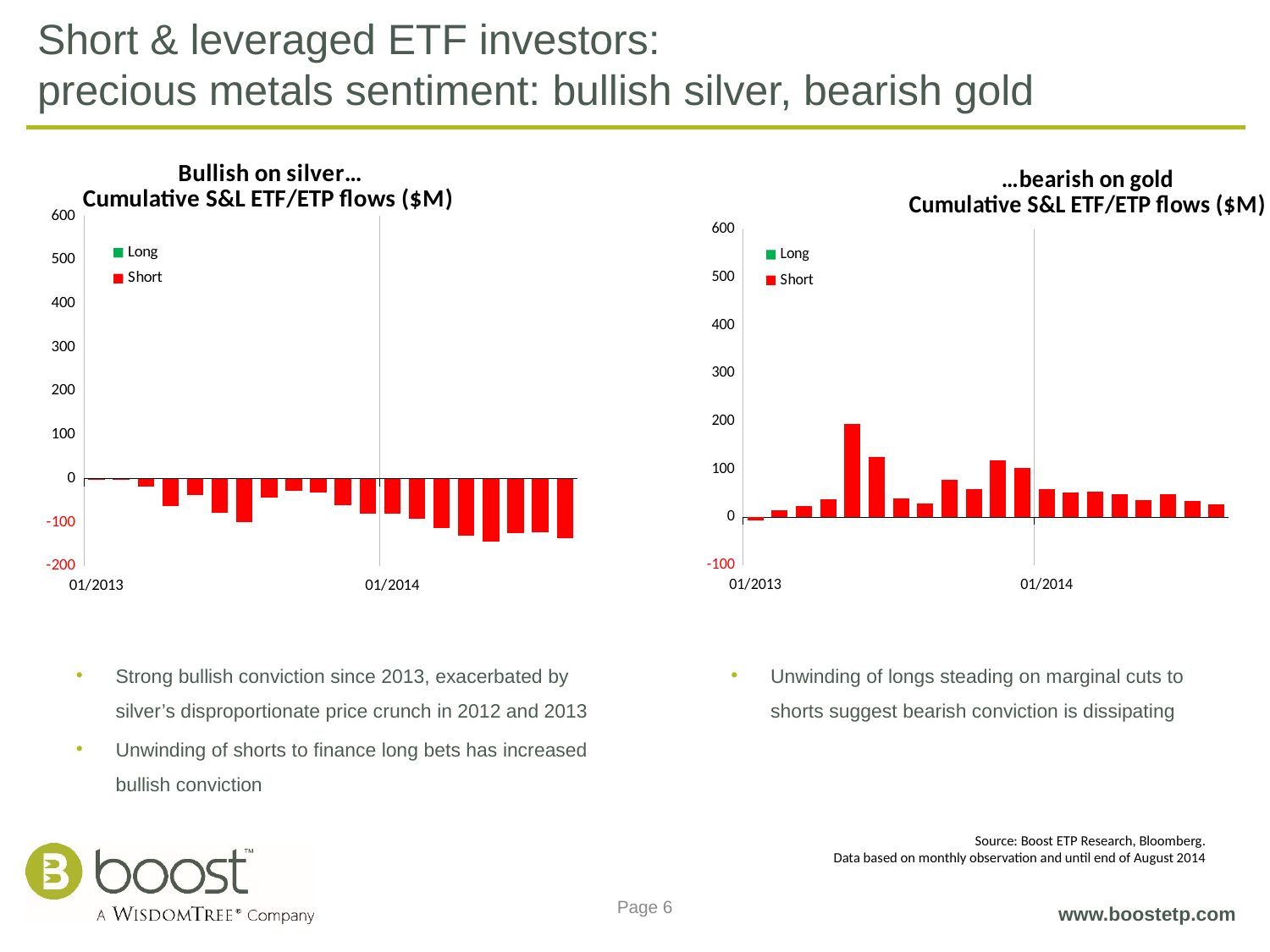
In the '…bearish on gold' chart, do the bar values rise or fall after the peak in 2013? fall In the 'Bullish on silver' chart, do the bar values generally rise or fall from 01/2013 to the end of the series? fall Which chart has the taller positive bars, 'Bullish on silver' or '…bearish on gold'? …bearish on gold What are the two legend entries in the '…bearish on gold' chart? Long and Short In the 'Bullish on silver' chart, are the bars above or below zero? below What type of chart is the '…bearish on gold' chart on the right? bar chart What is the lowest value shown on the vertical axis of the 'Bullish on silver' chart? -200 In the 'Bullish on silver' chart, is the lowest bar greater or less than -100? less In the '…bearish on gold' chart, is the tallest bar greater or less than 100? greater How many series does the legend list in the 'Bullish on silver' chart? 2 What type of chart is the 'Bullish on silver' chart on the left? bar chart